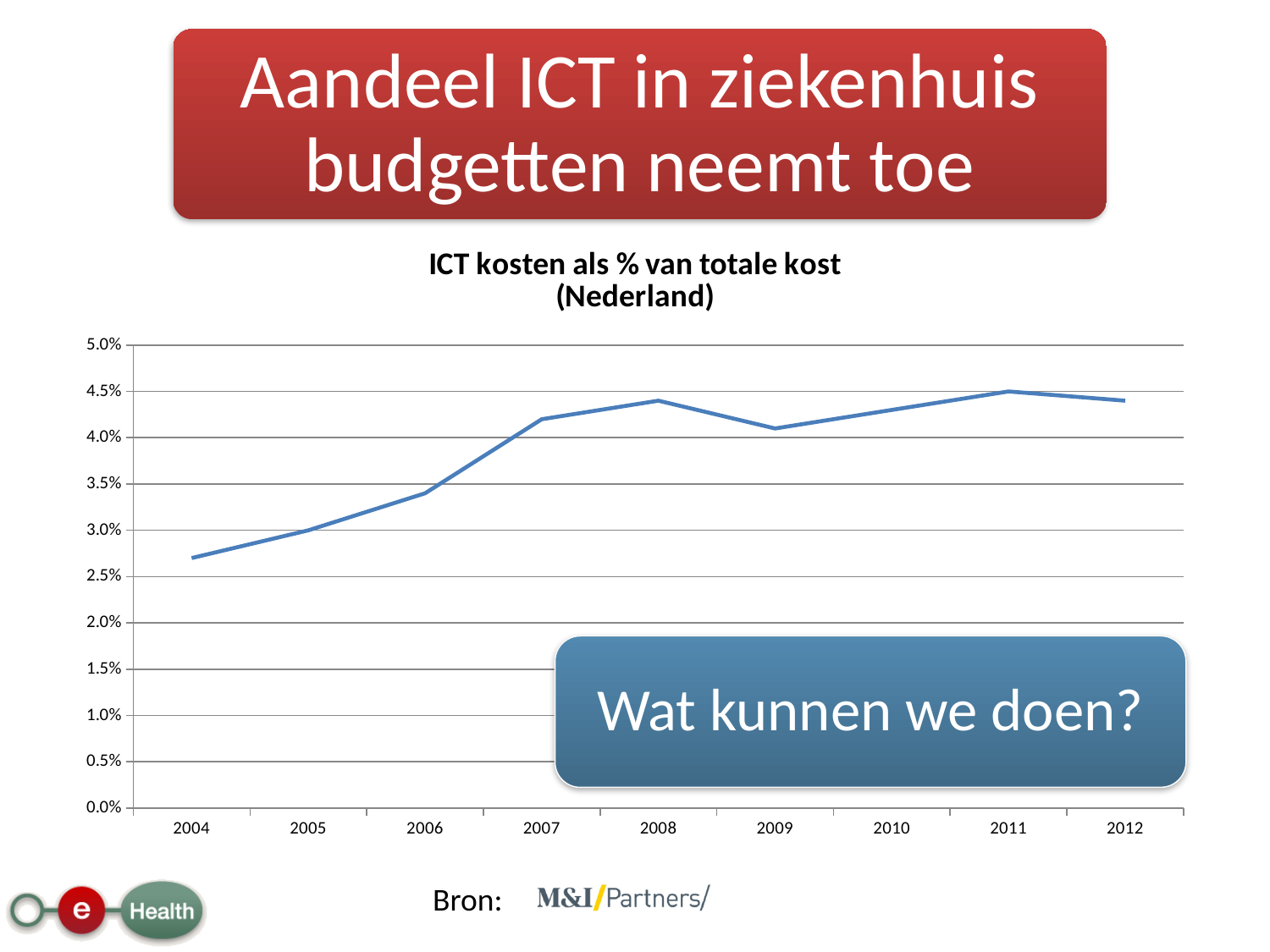
Does the ICT cost share generally rise or fall from 2004 to 2012? rise How many years are plotted on the x axis of the chart? 9 Is the value for 2004 greater or less than 3.0%? less Is the value for 2009 greater or less than 4.5%? less What kind of chart is shown on the slide? line chart Is the value for 2007 greater or less than 4.0%? greater Which year has the highest value in the chart? 2011 What is the title of the chart? ICT kosten als % van totale kost (Nederland) Which is larger, the value for 2006 or the value for 2010? 2010 Which is larger, the value for 2008 or the value for 2009? 2008 Which year has the lowest value in the chart? 2004